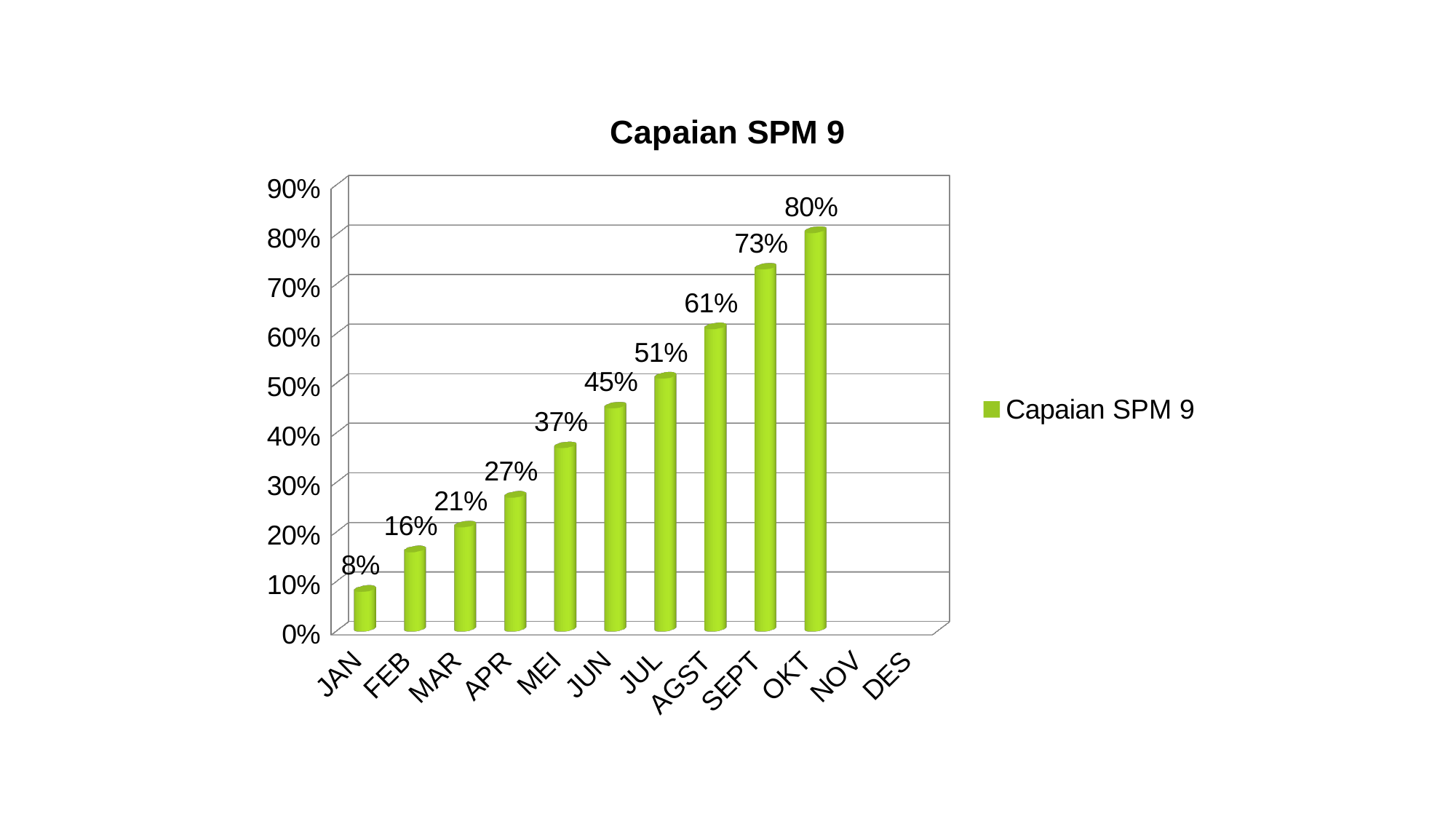
How many series does the legend list? 1 Which month with a plotted bar has the lowest value? JAN Which month has the highest value? OKT Which is larger, the value for APR or the value for MEI? MEI What is the value for SEPT? 73% Do the values rise or fall from JAN to OKT? Rise What is the value for JAN? 8% What is the difference between the values for JUL and MAR? 30% What is the value for JUN? 45% What kind of chart is shown? Bar chart What is the difference between the values for OKT and SEPT? 7% How many months are labelled on the x axis? 12